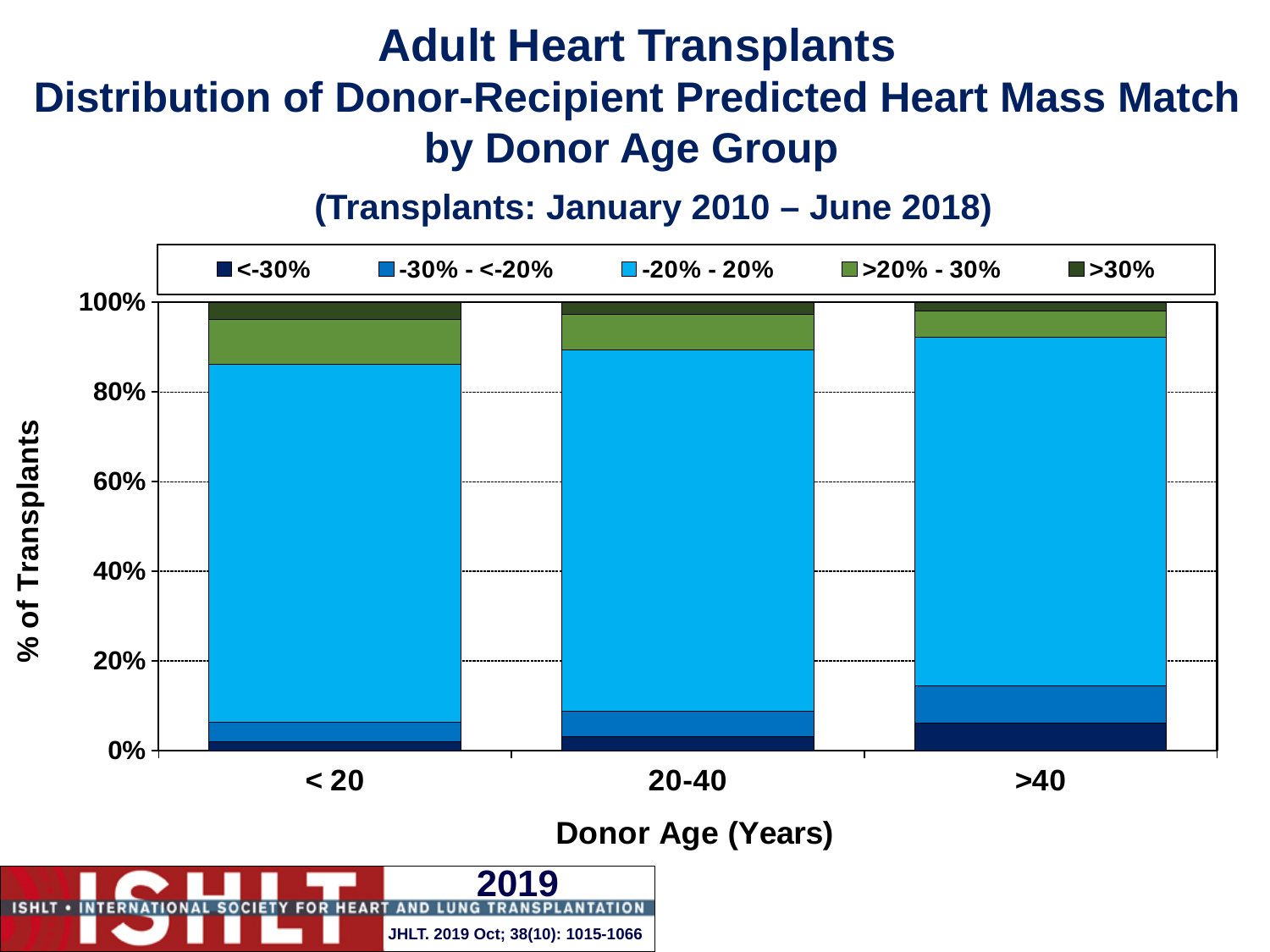
What is the title of the x axis? Donor Age (Years) Which donor age group has the largest >20% - 30% share? < 20 Is the <-30% segment larger for the < 20 group or the >40 group? >40 Is the value of the >30% segment for the < 20 donor age group greater or less than 20%? less What is the total height of the stacked bar for the >40 donor age group? 100% How many series does the legend list? 5 Is the value of the <-30% segment for the >40 donor age group greater or less than 20%? less Does the <-30% share rise or fall as donor age increases from < 20 to >40? Rises How many donor age groups are shown on the x axis? 3 Which donor age group has the largest <-30% share? >40 What is the title of the y axis? % of Transplants What kind of chart is shown on the slide? Stacked bar chart